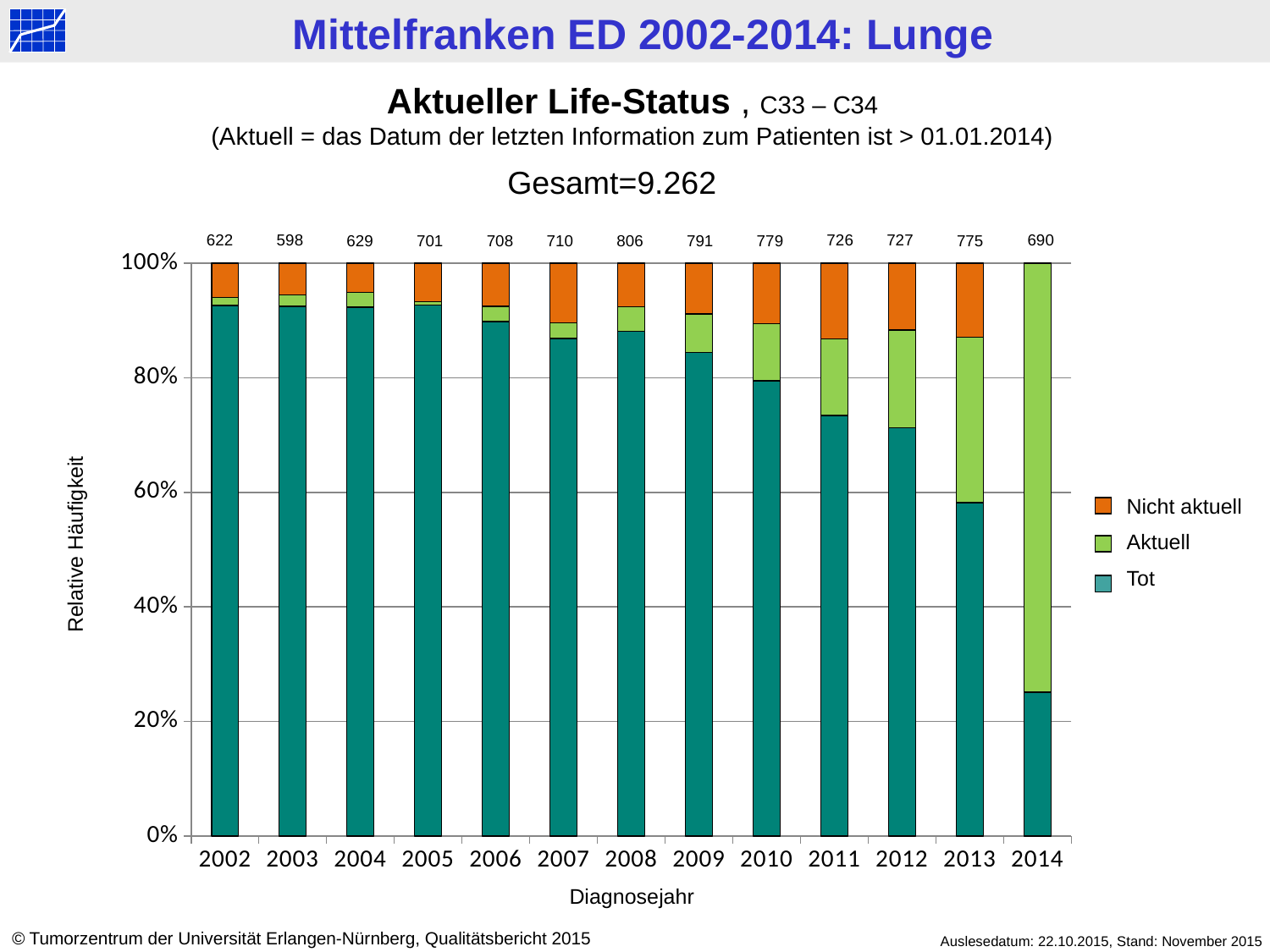
How many series does the legend list? 3 What number is printed above the bar for 2003? 598 What is the difference between the numbers printed above the bars for 2008 and 2003? 208 Does the 'Tot' share rise or fall from 2002 to 2014? fall Is the 'Tot' share for 2014 greater or less than 40%? less Which diagnosis year has the lowest number printed above its bar? 2003 How many diagnosis years are shown on the x axis? 13 Which year has the larger number printed above its bar, 2005 or 2011? 2011 What number is printed above the bar for 2008? 806 What number is printed above the bar for 2014? 690 Is the 'Tot' share for 2002 greater or less than 80%? greater Which diagnosis year has the highest number printed above its bar? 2008